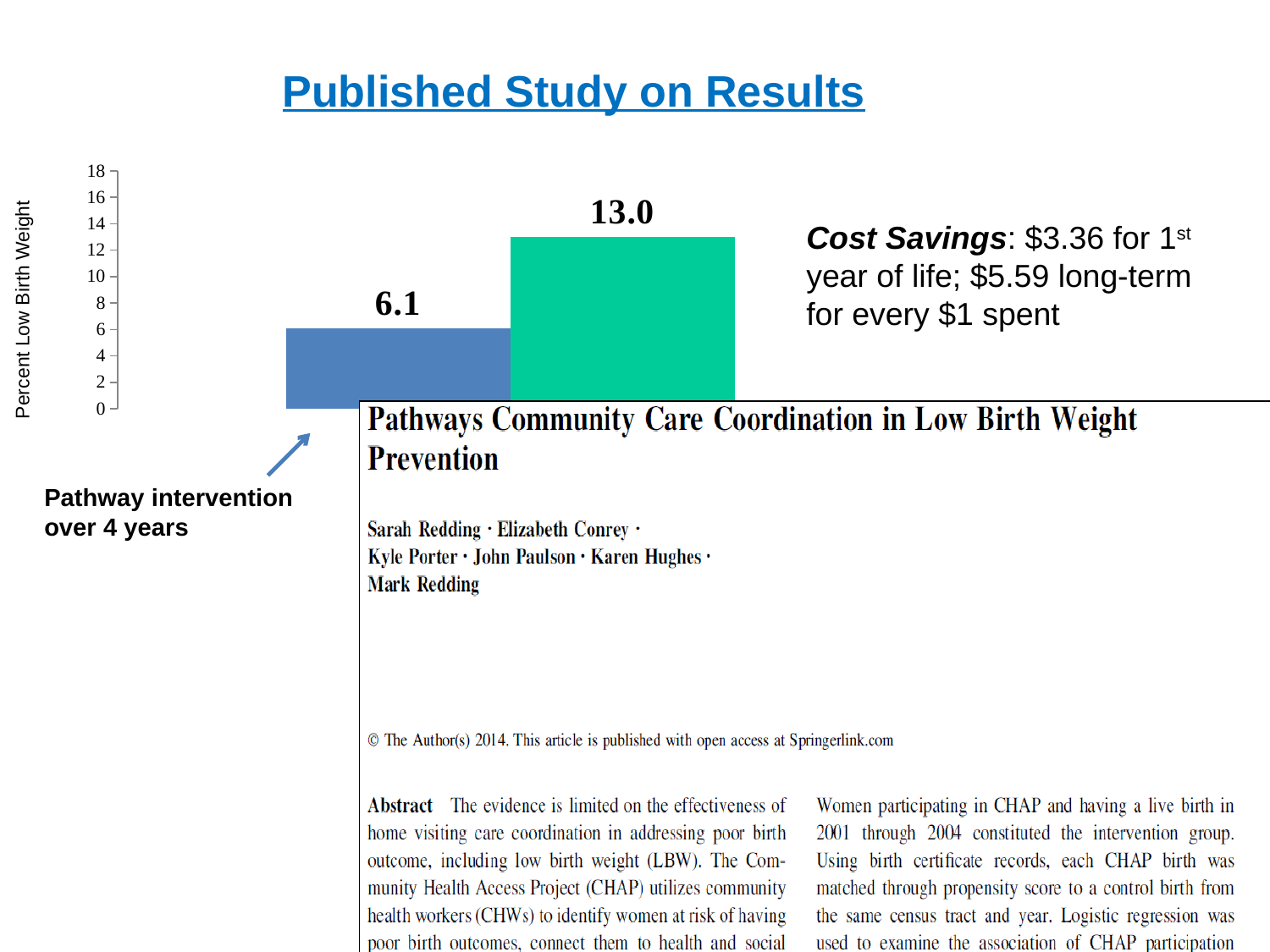
Which bar has the lower value, the blue bar or the green bar? the blue bar What is the value of the blue bar labelled "Pathway intervention over 4 years"? 6.1 What is the label on the vertical axis of the chart? Percent Low Birth Weight Is the value of the blue bar greater or less than 8? less Is the value for the Pathway intervention bar larger or smaller than the value for the green bar? smaller What kind of chart is shown on the slide? bar chart What is the highest tick value shown on the vertical axis? 18 How many bars are plotted in the chart? 2 Is the value of the green bar greater or less than 10? greater Which bar has the higher value, the blue bar or the green bar? the green bar What is the difference between the green bar's value and the blue bar's value? 6.9 What is the value of the green bar on the right? 13.0